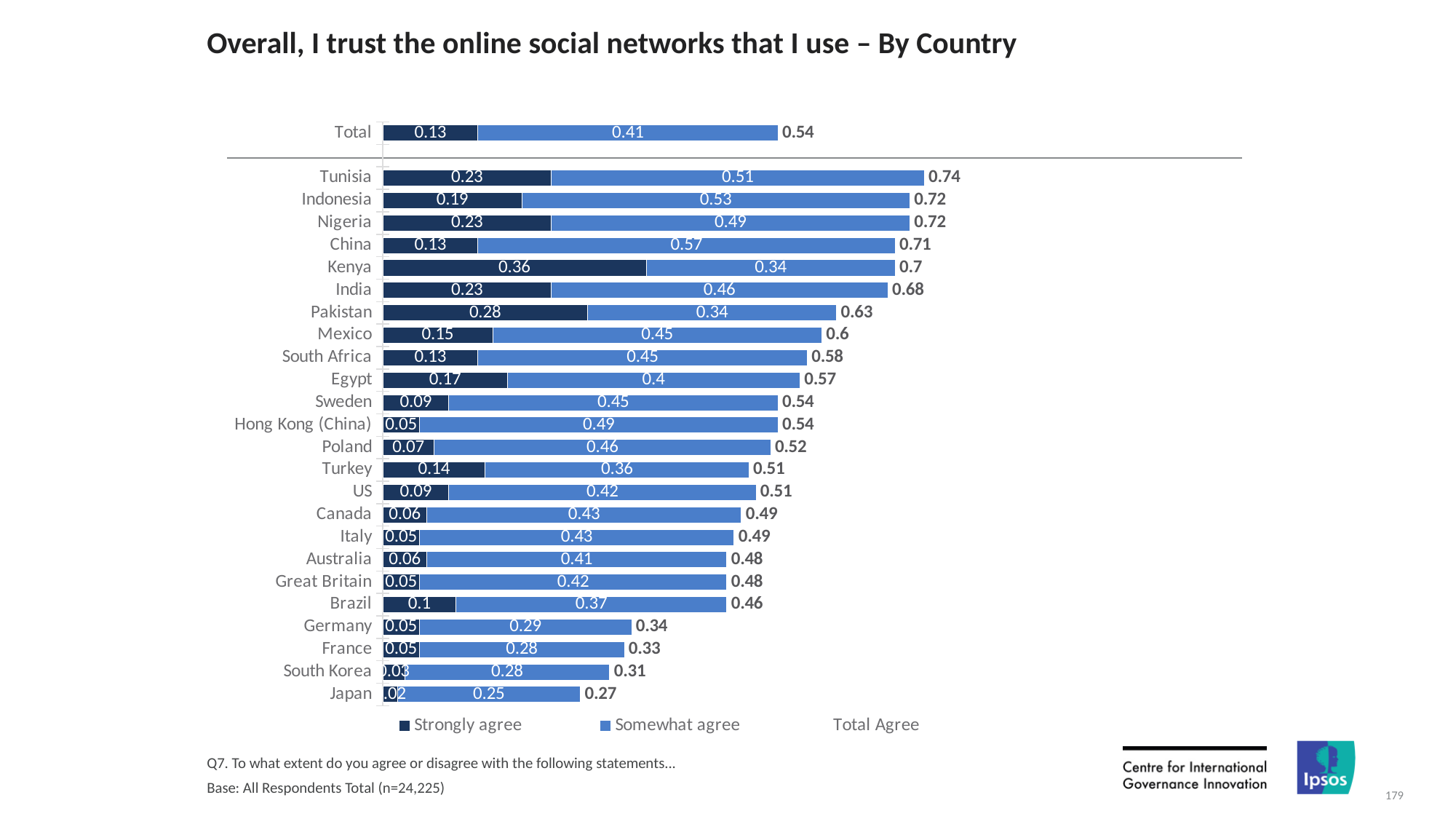
What kind of chart is shown on the slide? Stacked bar chart What is the difference between the Total Agree values for Tunisia and Japan? 0.47 What is the Somewhat agree value for China? 0.57 Which country has the highest Total Agree value? Tunisia What is the title of the chart? Overall, I trust the online social networks that I use – By Country Which has a larger Somewhat agree value, Indonesia or Kenya? Indonesia What is the Total Agree value for Pakistan? 0.63 What is the Strongly agree value for Kenya? 0.36 What is the Total Agree value for the Total row? 0.54 Which country has the lowest Total Agree value? Japan Which country has the highest Strongly agree value? Kenya How many series does the legend list? 3